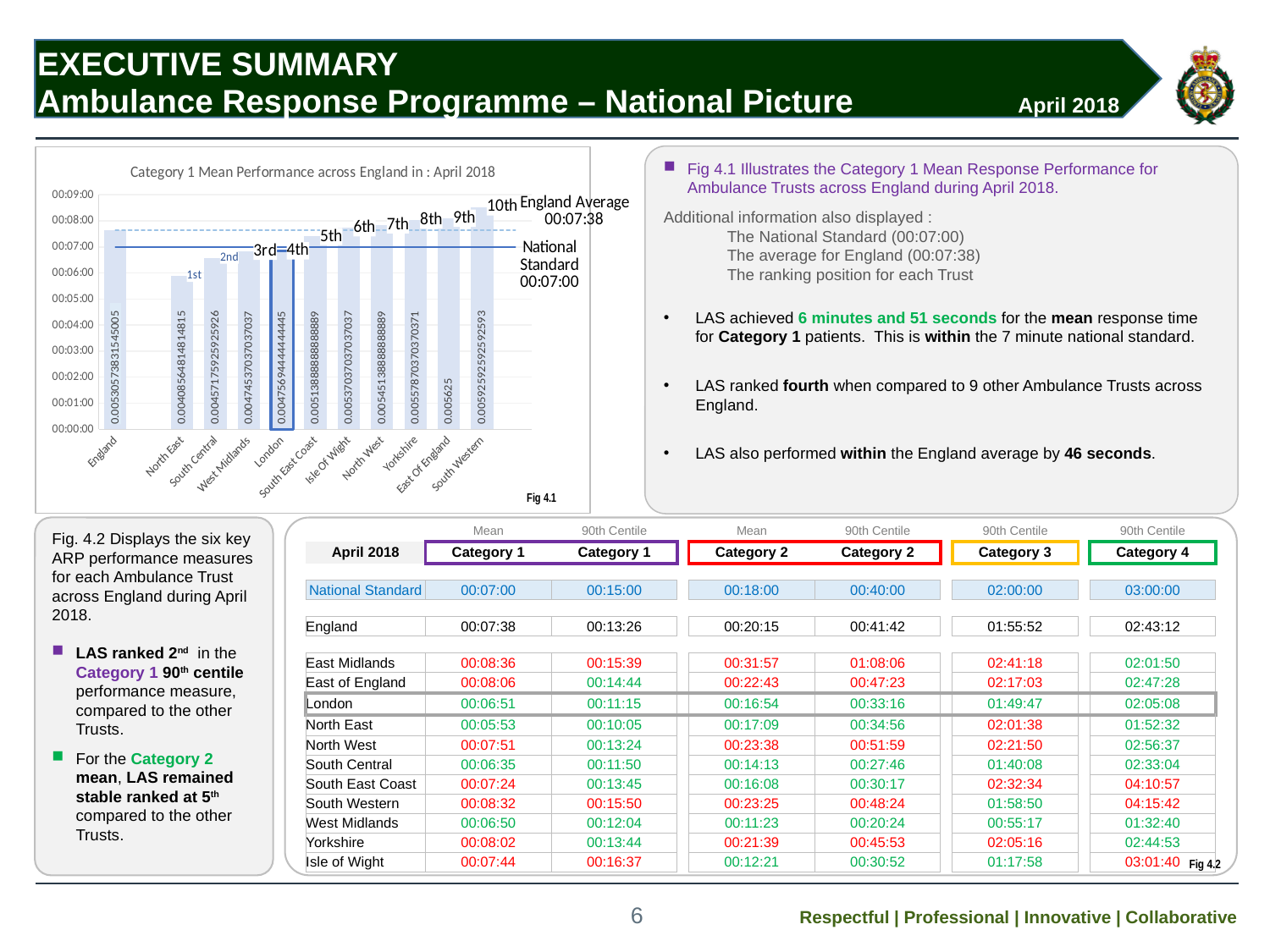
How many bars are plotted in the Category 1 Mean Performance chart? 11 In the Category 1 Mean Performance chart, is the value for England greater or less than 00:07:00? greater In the Category 1 Mean Performance chart, is the value for South Western greater or less than 00:08:00? greater What is the title of the chart in Fig 4.1? Category 1 Mean Performance across England in : April 2018 In the Category 1 Mean Performance chart, is the bar for South Western taller or shorter than the bar for North East? taller Which category has the tallest bar in the Category 1 Mean Performance chart? South Western Do the bars for the ambulance trusts (from North East to South Western) rise or fall from left to right in the Category 1 Mean Performance chart? rise What England Average value is printed on the Category 1 Mean Performance chart? 00:07:38 What type of chart is shown in Fig 4.1? bar chart What National Standard value is printed on the Category 1 Mean Performance chart? 00:07:00 Which category has the shortest bar in the Category 1 Mean Performance chart? North East